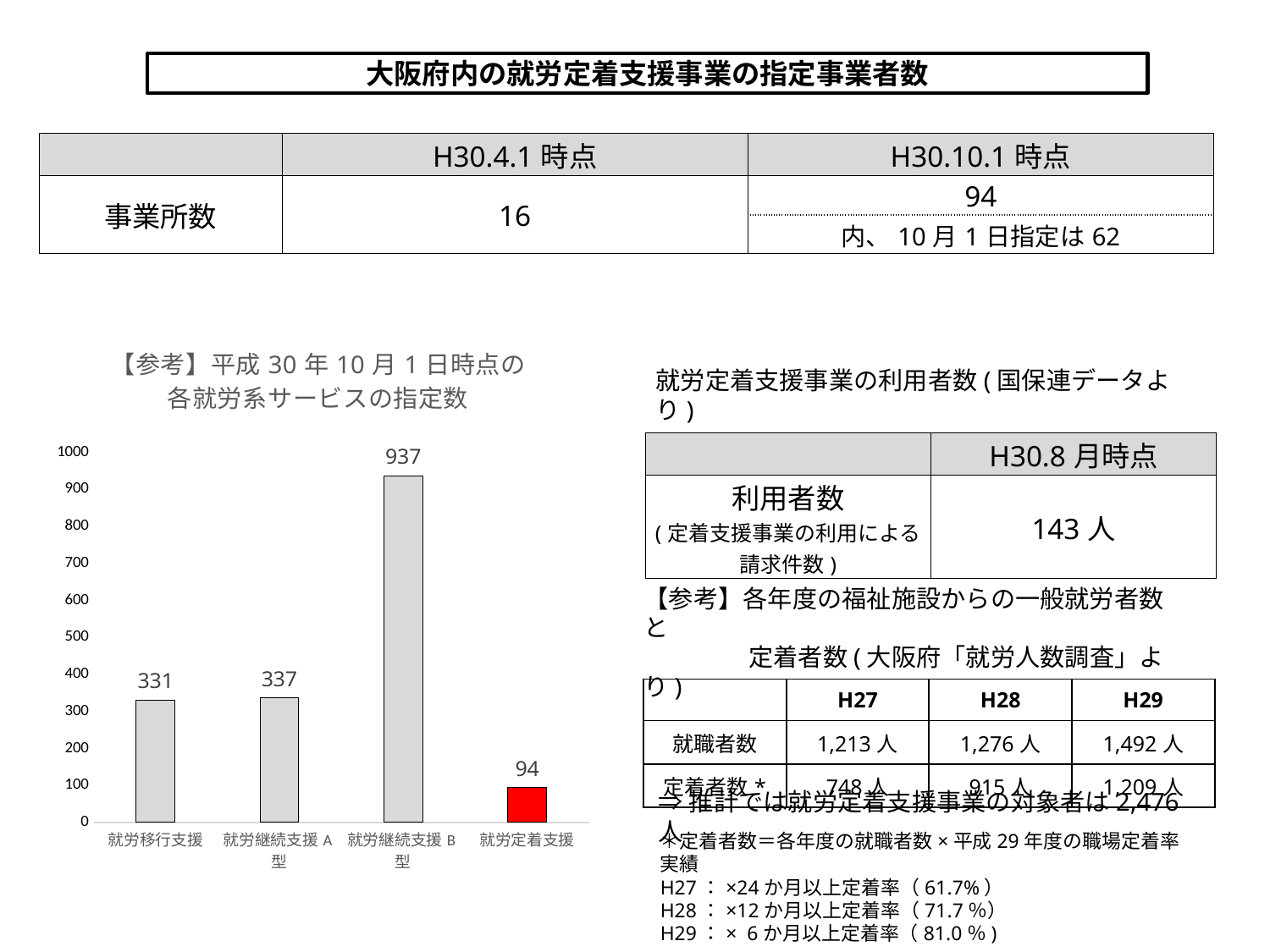
What is the value for 就労継続支援A型 in the bar chart? 337 Which category has the lowest value in the bar chart? 就労定着支援 How many categories are shown in the bar chart? 4 What is the value for 就労継続支援B型 in the bar chart? 937 Which is larger in the bar chart, the value for 就労移行支援 or the value for 就労継続支援B型? 就労継続支援B型 What kind of chart is shown on the slide? bar chart What is the difference between the values for 就労継続支援A型 and 就労移行支援 in the bar chart? 6 Which category's bar is coloured red in the bar chart? 就労定着支援 What is the value for 就労定着支援 in the bar chart? 94 Which category has the highest value in the bar chart? 就労継続支援B型 What is the difference between the values for 就労継続支援B型 and 就労定着支援 in the bar chart? 843 What is the value for 就労移行支援 in the bar chart? 331